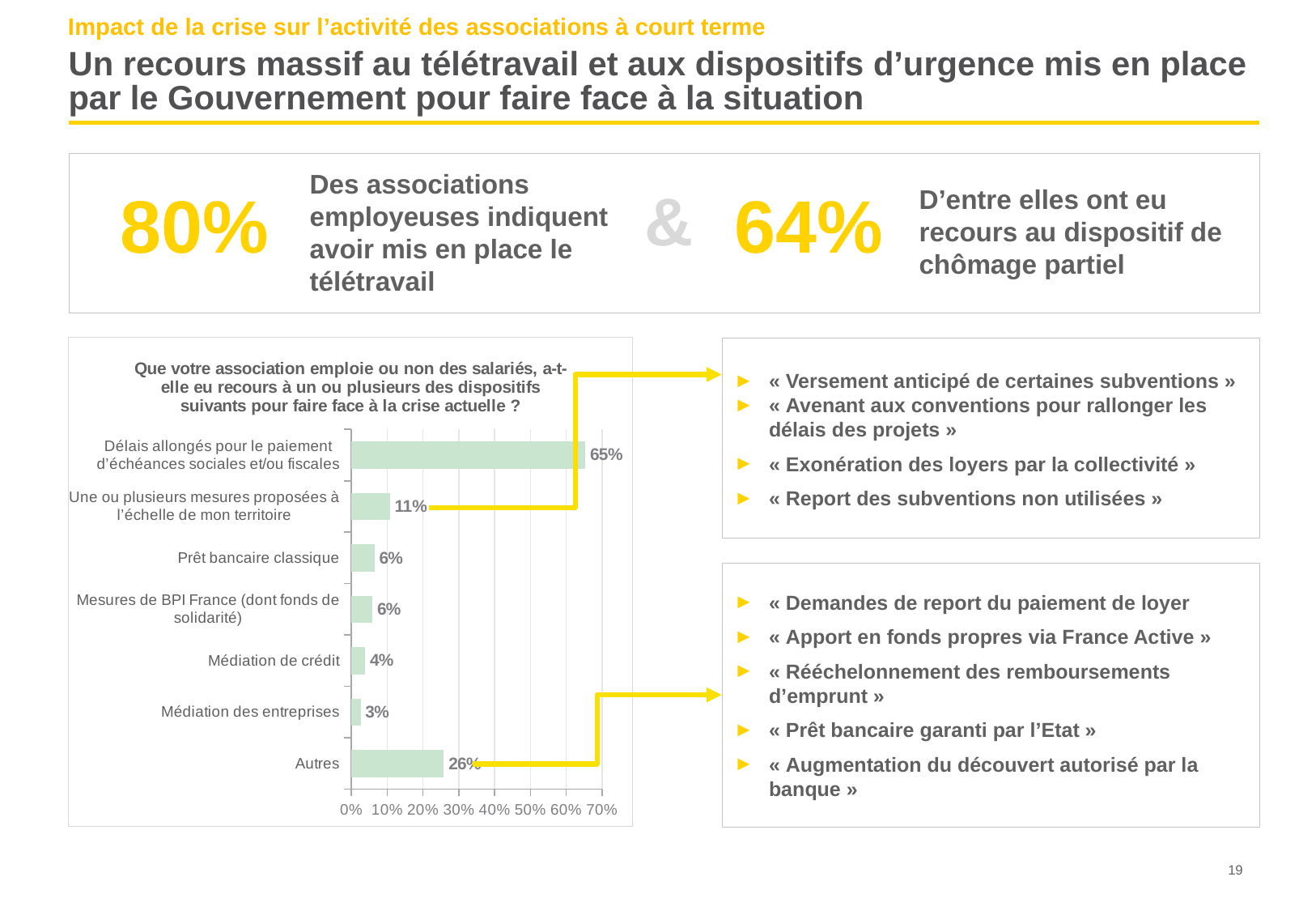
What is the value for "Délais allongés pour le paiement d'échéances sociales et/ou fiscales"? 65% How many categories does the bar chart show? 7 What kind of chart is shown on the slide? bar chart Which category has the lowest value in the bar chart? Médiation des entreprises What is the value for "Autres"? 26% What is the difference between the values for "Délais allongés pour le paiement d'échéances sociales et/ou fiscales" and "Autres"? 39% Which is larger, the value for "Autres" or the value for "Une ou plusieurs mesures proposées à l'échelle de mon territoire"? Autres What is the value for "Une ou plusieurs mesures proposées à l'échelle de mon territoire"? 11% What is the value for "Médiation des entreprises"? 3% What is the highest value shown on the x axis of the bar chart? 70% What is the difference between the values for "Médiation de crédit" and "Médiation des entreprises"? 1% Which category has the highest value in the bar chart? Délais allongés pour le paiement d'échéances sociales et/ou fiscales